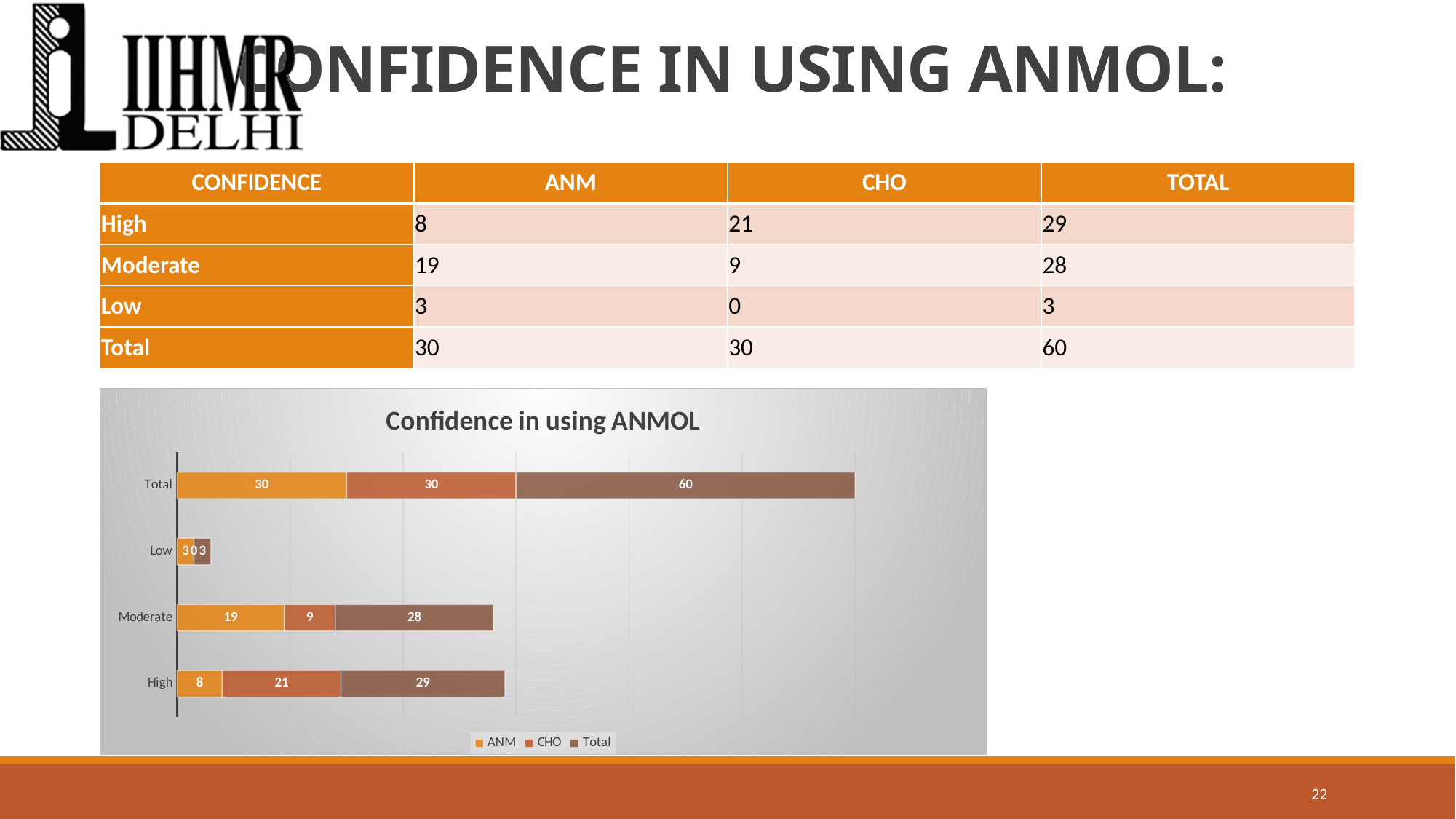
What type of chart is shown on the slide? Stacked bar chart Which category has the highest ANM value in the chart? Total What is the CHO value for the High category in the chart? 21 What is the title of the chart? Confidence in using ANMOL What is the difference between the CHO value and the ANM value for the High category? 13 For the Moderate category, which is larger: the ANM value or the CHO value? ANM What is the combined length of the stacked bar for the High category (ANM + CHO + Total)? 58 How many series does the chart legend list? 3 What is the ANM value for the Moderate category in the chart? 19 How many categories are shown on the chart's vertical axis? 4 Which category has the lowest CHO value in the chart? Low What is the Total series value for the Low category in the chart? 3